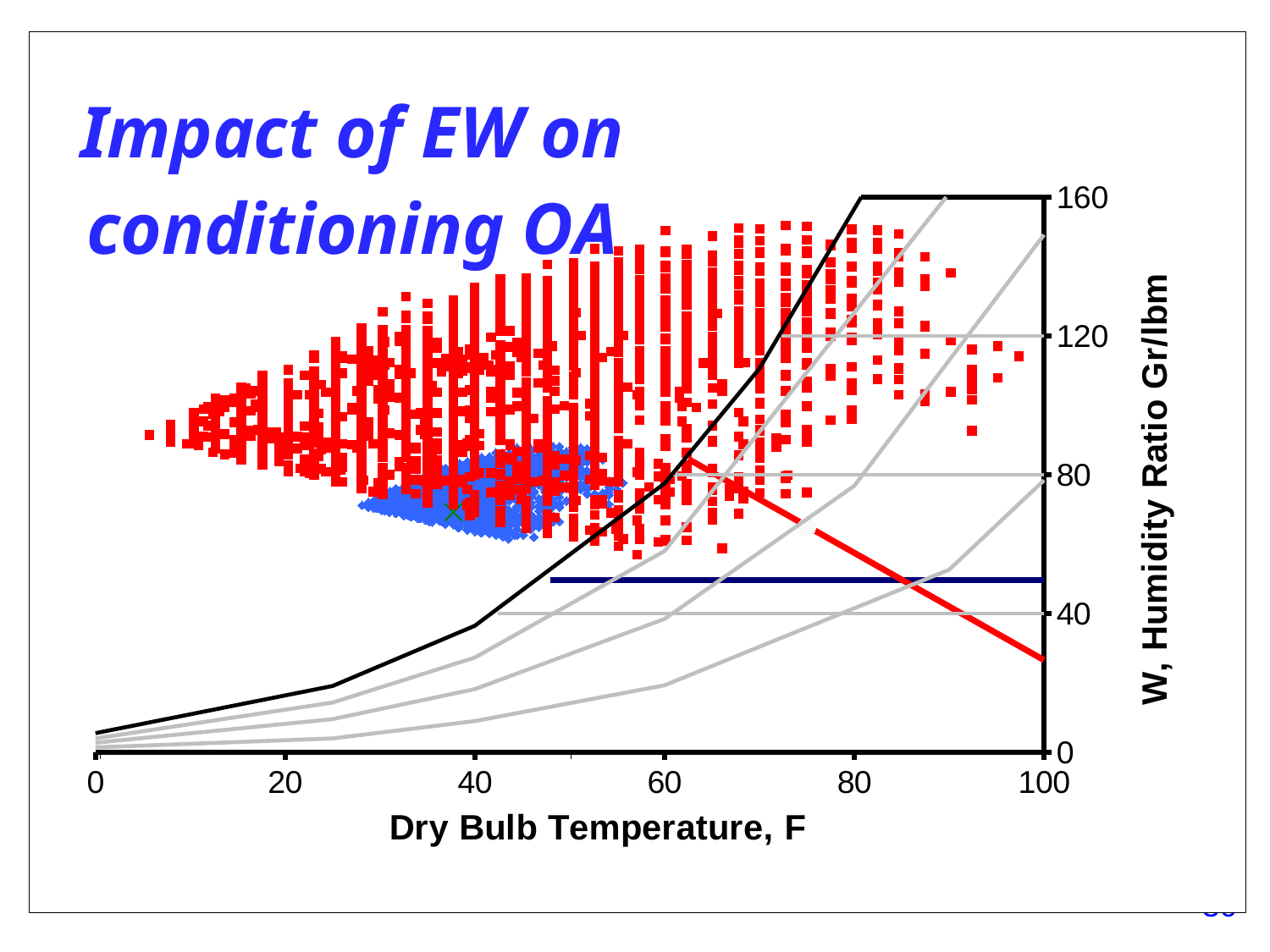
What is the highest tick value shown on the y axis? 160 What is the label of the x axis? Dry Bulb Temperature, F Is the value of the horizontal navy line greater or less than 40? greater Does the black curve rise or fall as dry bulb temperature increases from 0 to 80 F? rise What kind of chart is shown on the slide? scatter chart Is the value of the black curve at 40 F greater or less than 80? less What is the highest tick value shown on the x axis? 100 Is the value of the horizontal navy line greater or less than 80? less What is the title of the slide's chart? Impact of EW on conditioning OA Does the red line rise or fall as dry bulb temperature increases from 60 to 100 F? fall